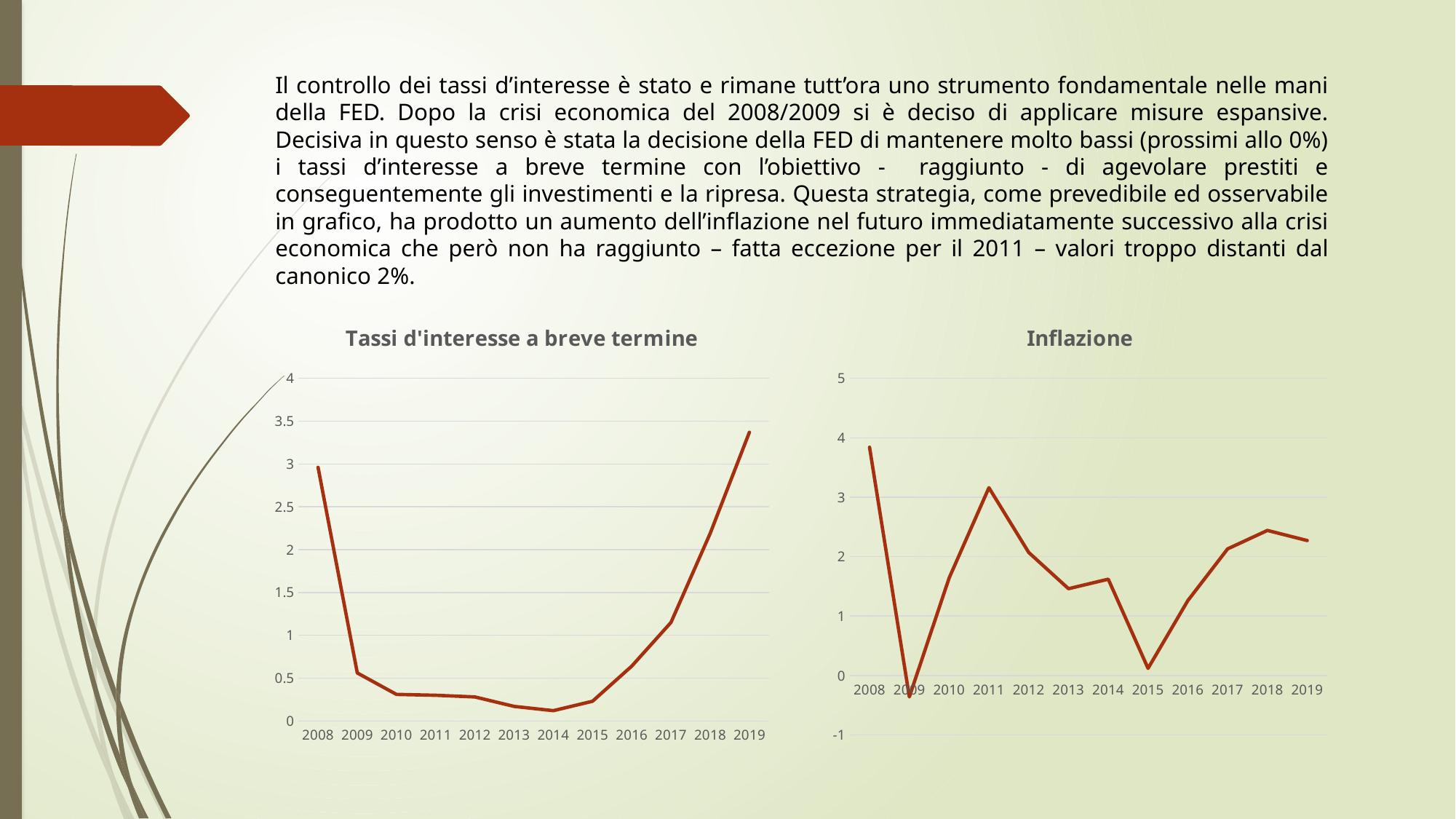
In the 'Tassi d'interesse a breve termine' chart, which year has the highest value? 2019 What kind of chart is the 'Tassi d'interesse a breve termine' chart? line chart In the 'Tassi d'interesse a breve termine' chart, do the values rise or fall from 2015 to 2019? rise In the 'Inflazione' chart, is the value for 2015 greater or less than 1? less How many years are plotted on the 'Inflazione' chart? 12 What is the title of the chart on the right side of the slide? Inflazione In the 'Tassi d'interesse a breve termine' chart, is the value for 2008 greater or less than 2.5? greater In the 'Inflazione' chart, which year has the lowest value? 2009 In the 'Tassi d'interesse a breve termine' chart, is the value for 2014 greater or less than 0.5? less In the 'Tassi d'interesse a breve termine' chart, which year has the larger value, 2009 or 2017? 2017 In the 'Inflazione' chart, which year has the highest value? 2008